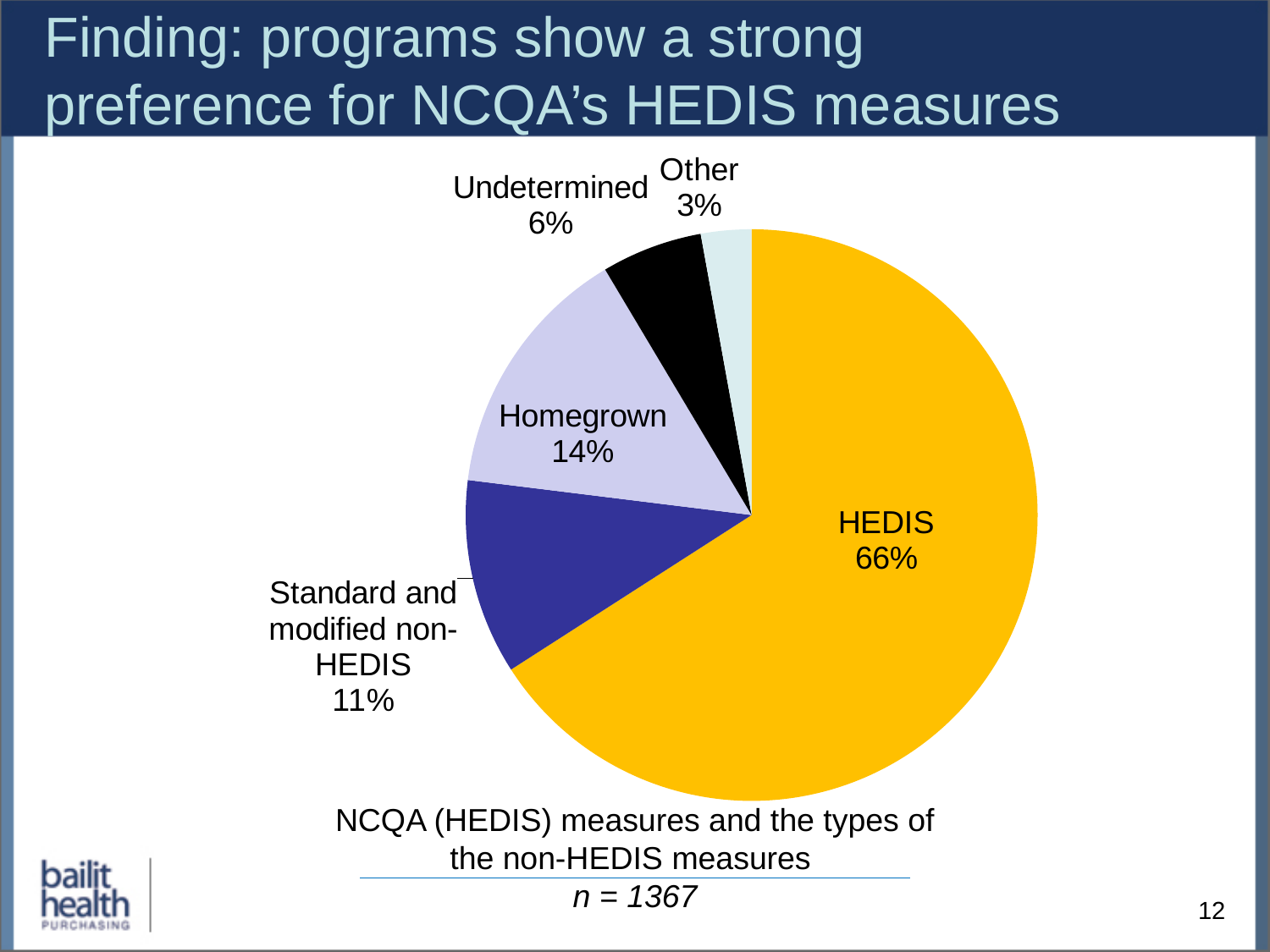
How many categories are shown in the pie chart? 5 What is the difference in percentage points between HEDIS and Homegrown? 52 Which category has the smallest slice of the pie? Other Which category has the largest slice of the pie? HEDIS What percentage is shown for Other? 3% What percentage is shown for Standard and modified non-HEDIS measures? 11% What percentage is shown for Undetermined? 6% What share of the pie does HEDIS account for? 66% Which is larger, the Homegrown slice or the Standard and modified non-HEDIS slice? Homegrown What is the sample size (n) stated below the chart? n = 1367 What type of chart is shown on the slide? Pie chart What percentage is shown for Homegrown measures? 14%